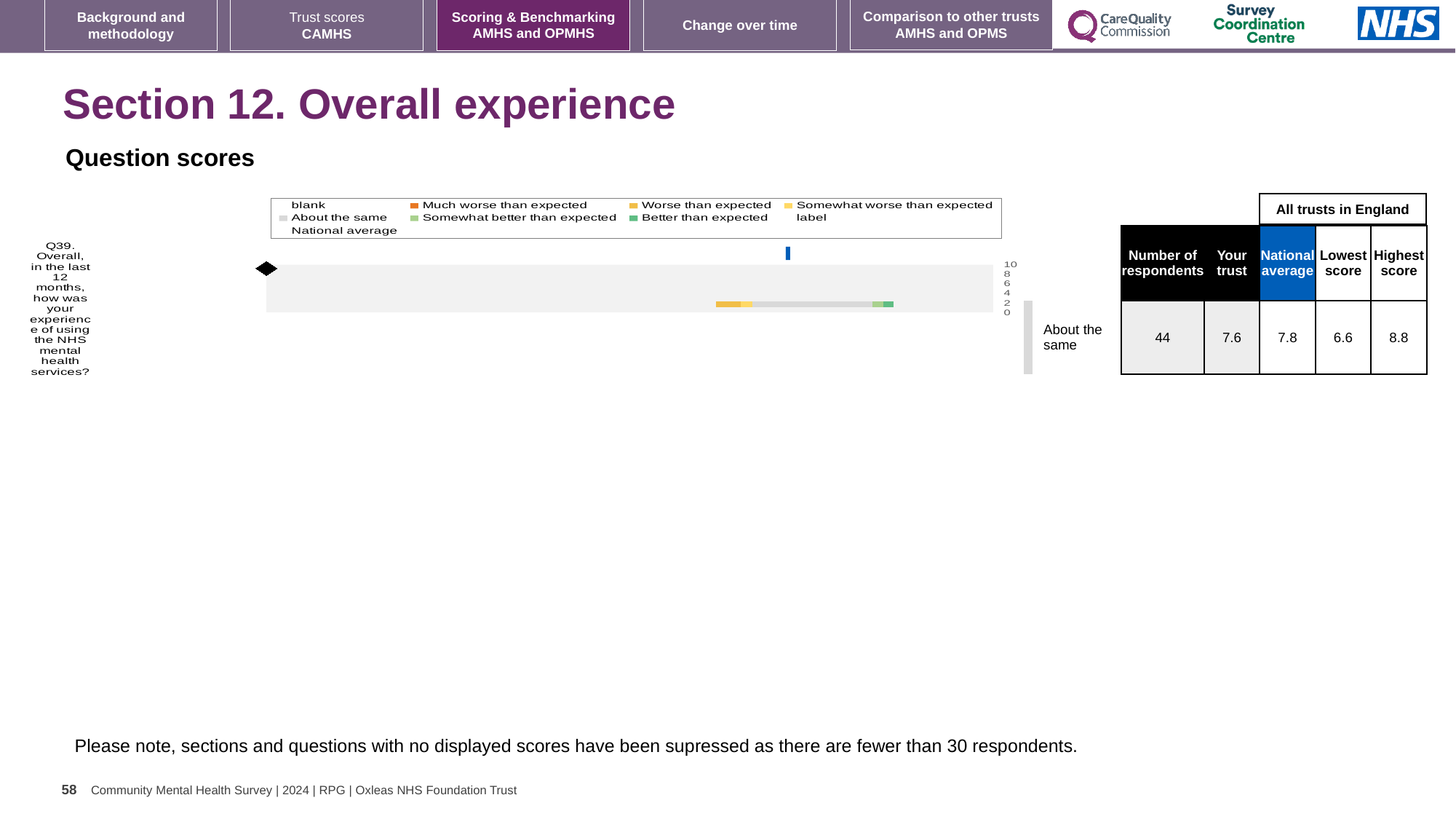
What is the highest score among all trusts in England for Q39? 8.8 Which is larger for Q39: the 'Your trust' score or the national average? National average How many respondents answered Q39? 44 What kind of chart is shown on the slide for Q39? bar chart What is the difference between the highest score and the lowest score for Q39? 2.2 What benchmark category is shown next to the chart for Q39? About the same How many questions are plotted on the chart? 1 What is the highest value shown on the chart's score axis? 10 What is the 'Your trust' score for Q39 (Overall, in the last 12 months, how was your experience of using the NHS mental health services?)? 7.6 By how much does the national average exceed the 'Your trust' score for Q39? 0.2 What is the lowest score among all trusts in England for Q39? 6.6 What is the national average score for Q39? 7.8